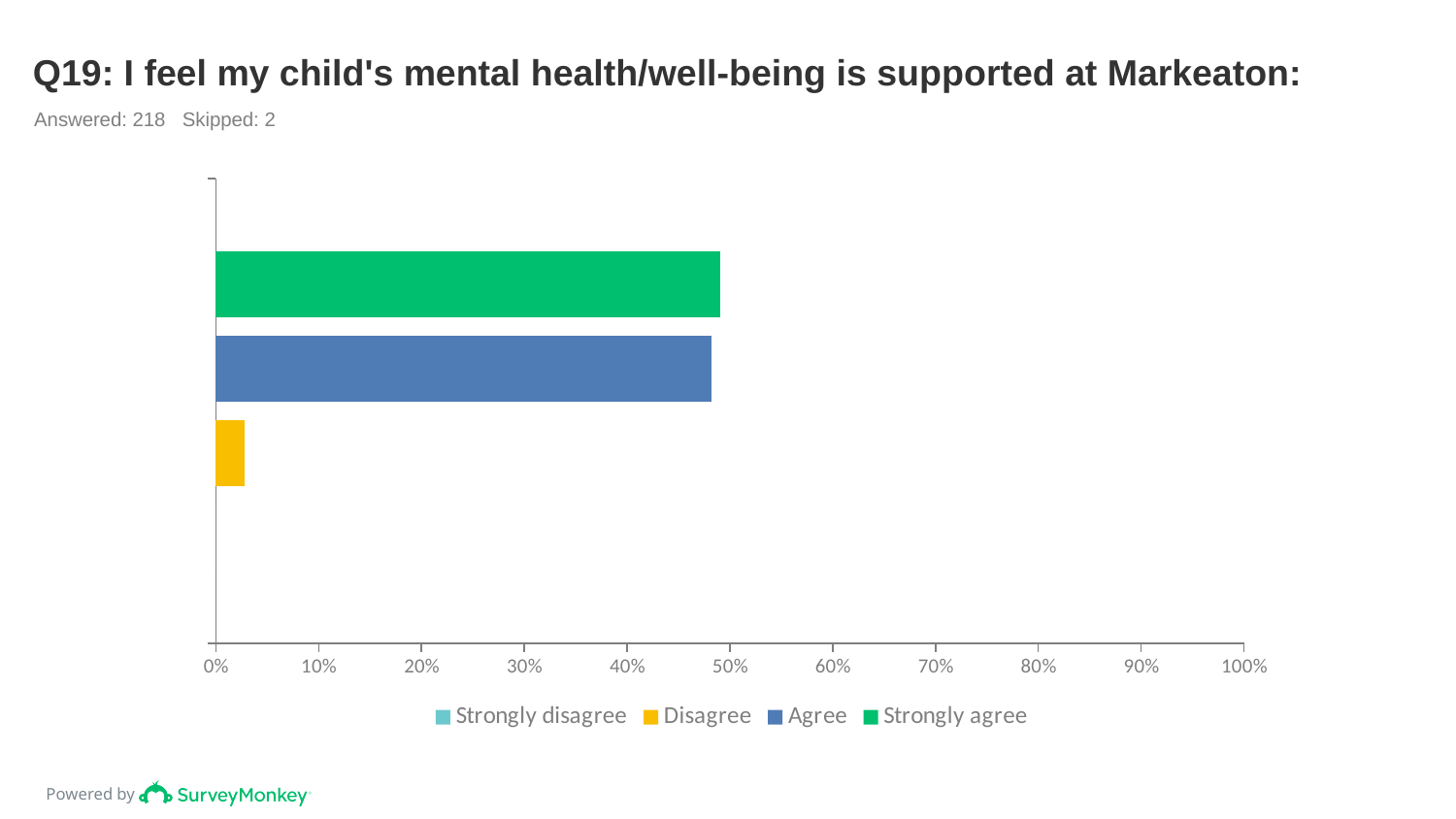
What kind of chart is shown on the slide? Bar chart Which is larger, the value for Agree or the value for Disagree? Agree What is the highest value shown on the horizontal axis? 100% Is the value for Agree greater or less than 40%? greater Is the value for Strongly agree greater or less than 60%? less Is the value for Disagree greater or less than 10%? less How many series does the legend list? 4 Which is larger, the value for Strongly agree or the value for Disagree? Strongly agree What colour is the bar for Strongly agree? Green